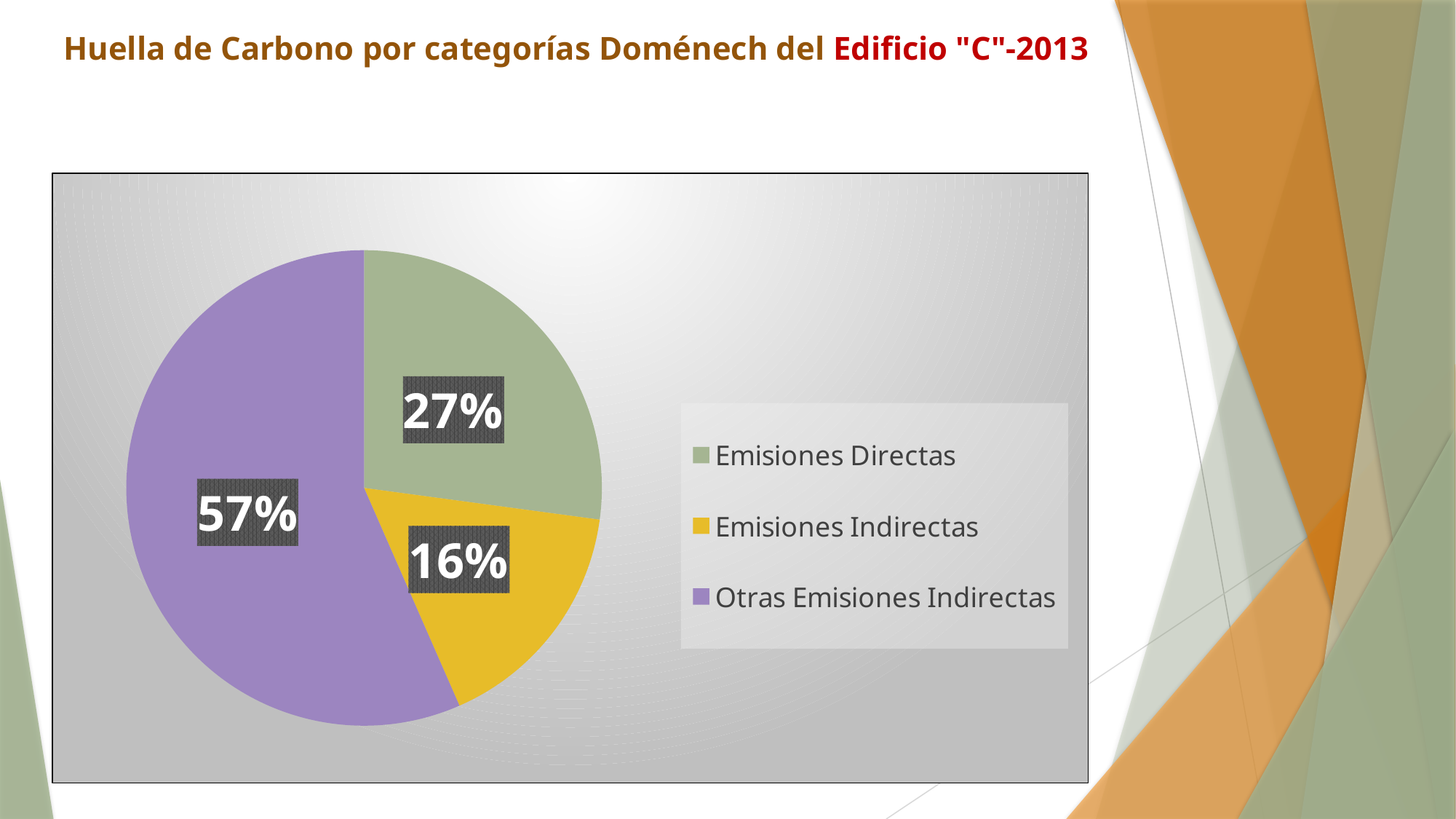
What colour is the slice for Otras Emisiones Indirectas? Purple What is the title of the slide containing the chart? Huella de Carbono por categorías Doménech del Edificio "C"-2013 What is the difference in percentage points between Otras Emisiones Indirectas and Emisiones Directas? 30 What kind of chart is shown on the slide? Pie chart What share of the pie does Emisiones Indirectas represent? 16% Which category has the smallest slice of the pie? Emisiones Indirectas What share of the pie does Otras Emisiones Indirectas represent? 57% Which is larger, the share for Emisiones Directas or the share for Emisiones Indirectas? Emisiones Directas Which category has the largest slice of the pie? Otras Emisiones Indirectas What is the difference in percentage points between Emisiones Directas and Emisiones Indirectas? 11 How many categories are shown in the pie chart? 3 What share of the pie does Emisiones Directas represent? 27%